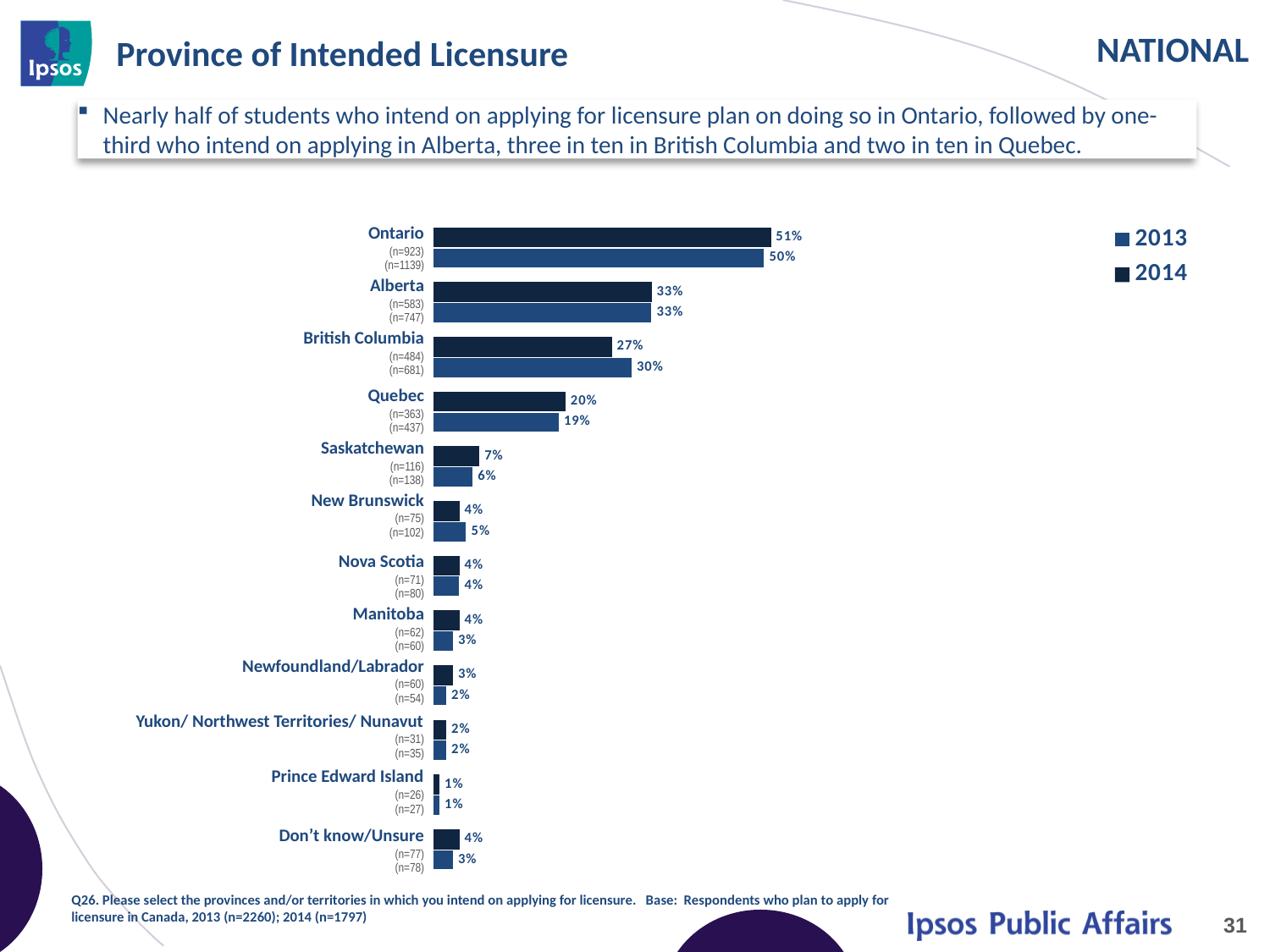
What percentage of students intended to apply for licensure in Ontario in 2014? 50% How many categories are shown on the chart? 12 Which province has the highest value in 2014? Ontario What is the difference between the 2013 and 2014 values for British Columbia? 3% What is the title of the slide? Province of Intended Licensure Which is larger for Saskatchewan: the 2013 value or the 2014 value? 2013 What was the 2013 value for British Columbia? 27% What percentage intended to apply in Quebec in 2013? 20% What is the difference between Ontario and Alberta in 2013? 18% Which province or territory has the lowest value in 2013? Prince Edward Island How many series does the legend list? 2 What type of chart is shown on the slide? Bar chart